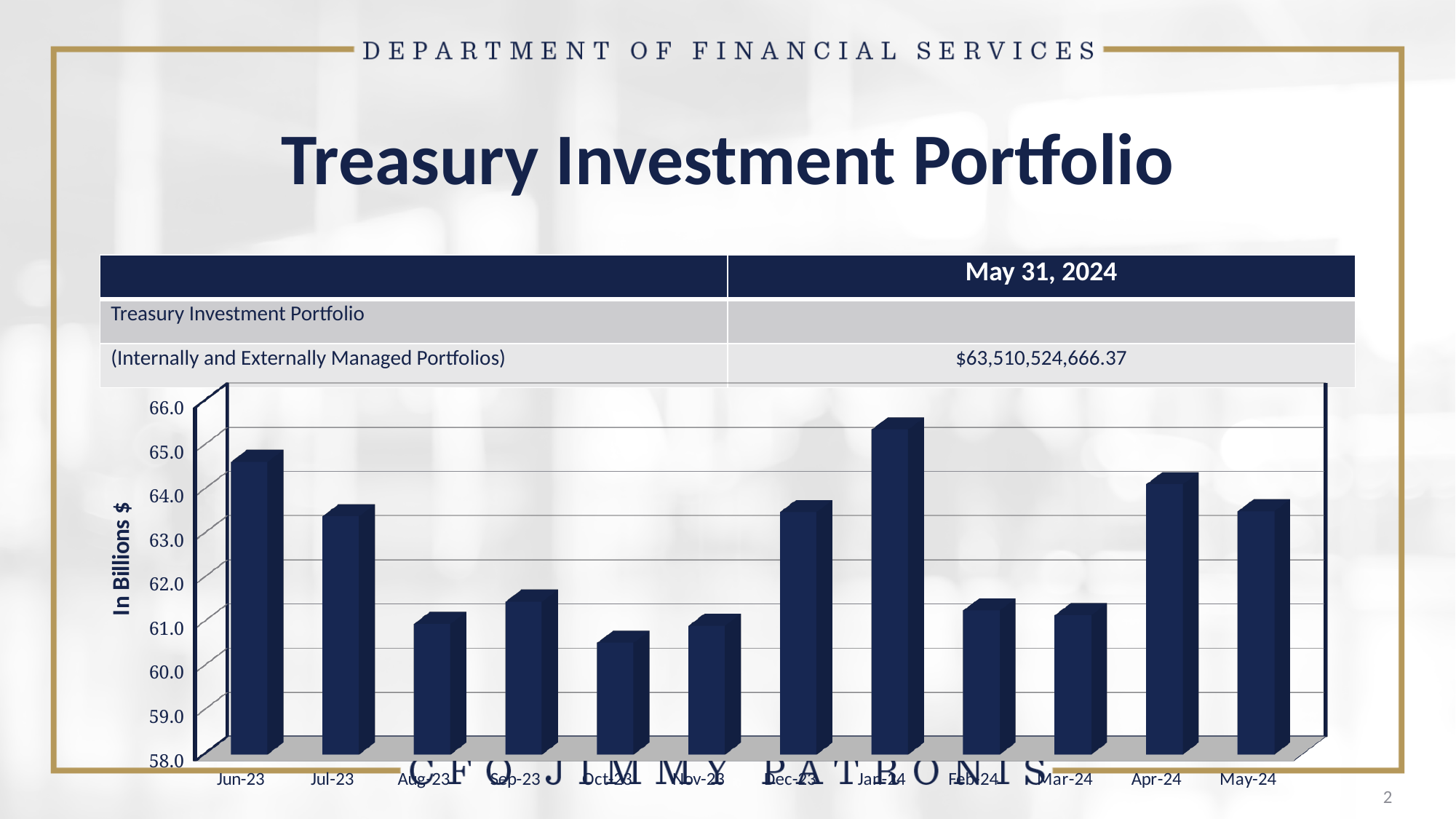
Which is larger, the value for Jan-24 or the value for Apr-24? Jan-24 Which month has the lowest value on the chart? Oct-23 Which is larger, the value for Jun-23 or the value for Jul-23? Jun-23 Is the value for Jun-23 greater or less than 64.0? greater What is the label on the vertical axis of the chart? In Billions $ Which month has the highest value on the chart? Jan-24 How many months are plotted on the chart? 12 Is the value for Oct-23 greater or less than 61.0? less What kind of chart is shown on the slide? bar chart Is the value for Jan-24 greater or less than 65.0? greater